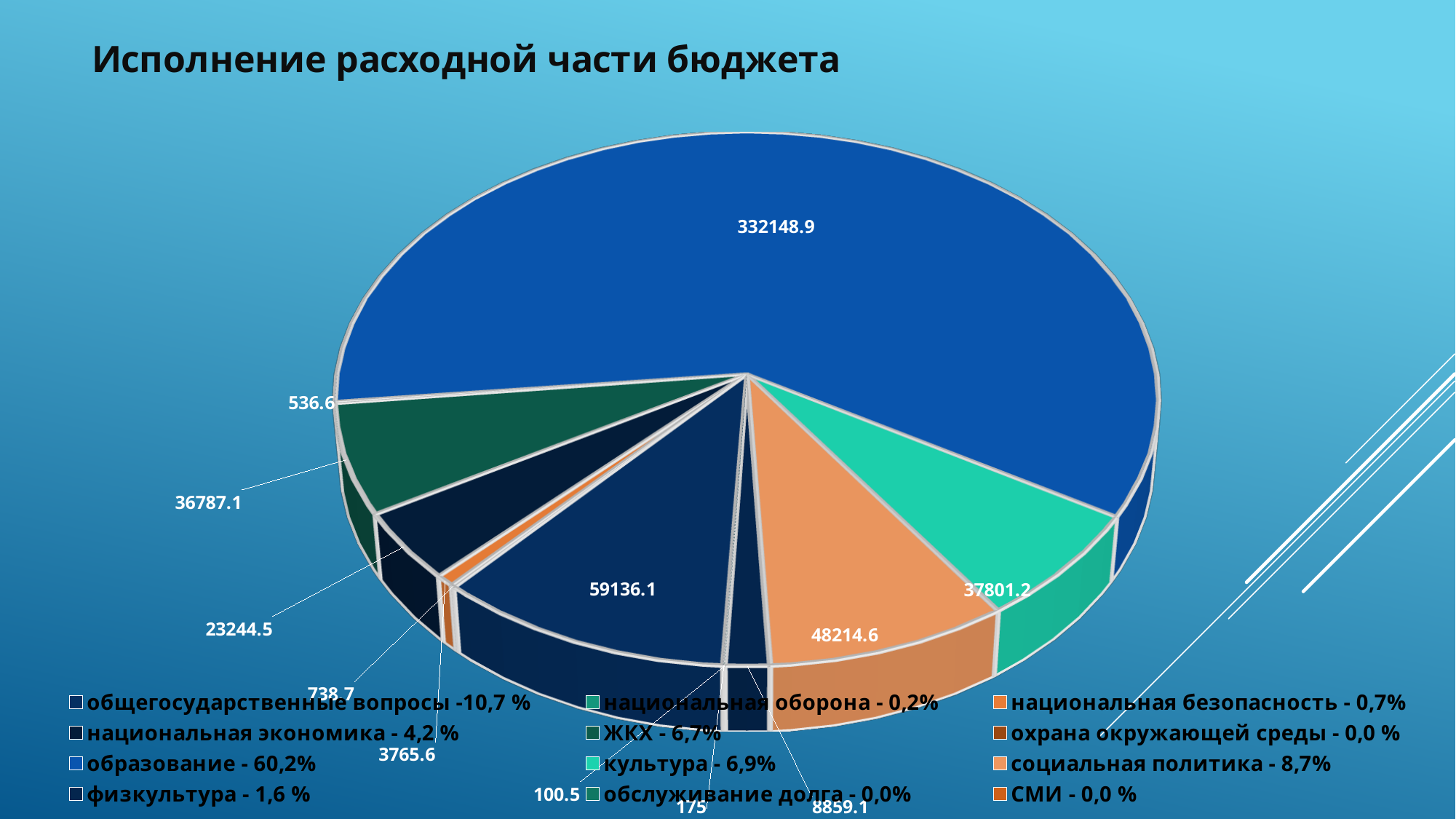
How many categories in the legend are shown with a share of 0,0 %? 3 What share of the pie does образование have? 60,2% By how many percentage points does the share of образование exceed the share of общегосударственные вопросы? 49,5 What share of the pie does национальная экономика have? 4,2 % Which category has the largest share of the pie? образование How many categories does the legend list? 12 Which has the larger share, ЖКХ or культура? культура What is the title of the chart? Исполнение расходной части бюджета What share of the pie does социальная политика have? 8,7% What is the data label on the largest slice of the pie? 332148.9 What is the data label on the социальная политика slice? 48214.6 What kind of chart is shown on the slide? pie chart